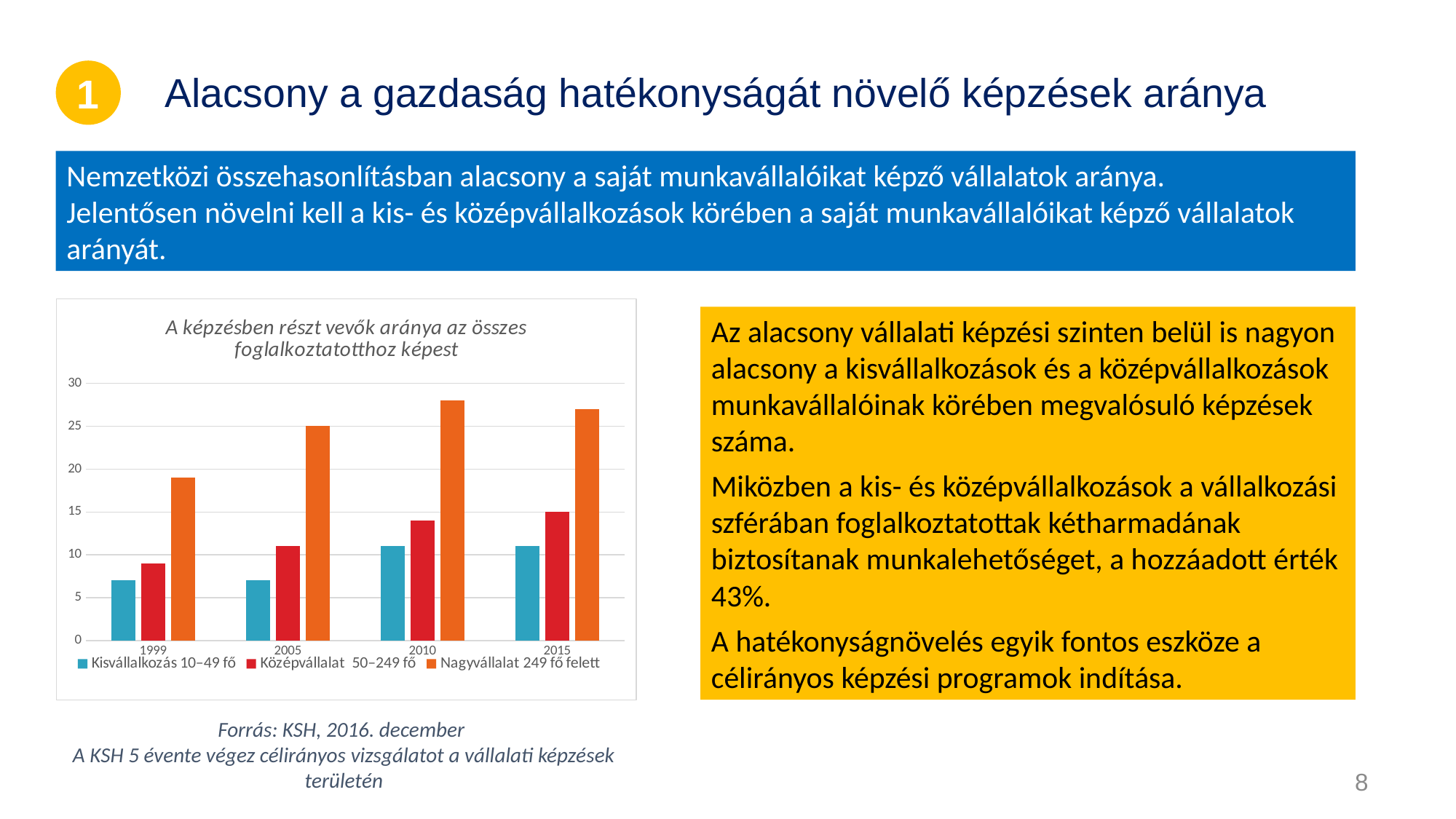
Which series has the highest bar in 2015? Nagyvállalat 249 fő felett What is the value for Nagyvállalat 249 fő felett in 2005? 25 What is the title of the chart? A képzésben részt vevők aránya az összes foglalkoztatotthoz képest Is the value for Kisvállalkozás 10–49 fő in 1999 greater or less than 10? less How many years are shown on the x axis of the chart? 4 How many series does the chart legend list? 3 What kind of chart is shown on the slide? bar chart Which series has the lowest bar in 1999? Kisvállalkozás 10–49 fő Is the value for Nagyvállalat 249 fő felett in 1999 greater or less than 20? less Do the values for Középvállalat 50–249 fő rise or fall from 1999 to 2015? rise Is the value for Középvállalat 50–249 fő in 2010 greater or less than 10? greater In 2015, which is larger: the value for Középvállalat 50–249 fő or for Kisvállalkozás 10–49 fő? Középvállalat 50–249 fő